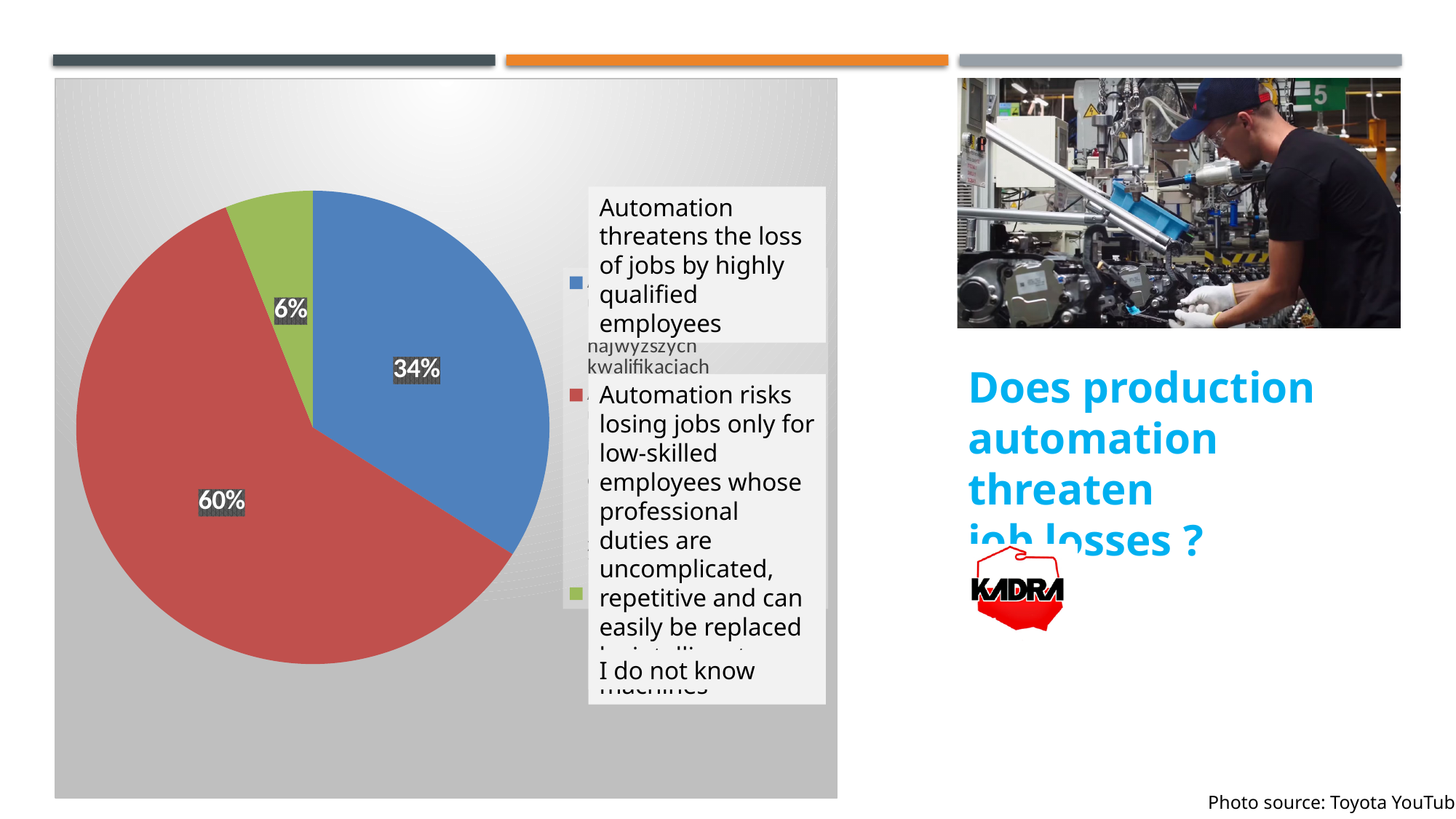
Which is larger: the share for highly qualified employees losing jobs or the share for low-skilled employees losing jobs? low-skilled employees losing jobs (60%) How many slices does the pie chart have? 3 What is the difference in percentage points between the red slice (60%) and the blue slice (34%)? 26 What kind of chart is shown on the slide? pie chart What colour is the slice labelled 60%? red What is the difference in percentage points between the blue slice (34%) and the green slice (6%)? 28 Which slice of the pie chart is the smallest? 6% (I do not know) What colour is the slice labelled 6%? green What share of the pie is the green slice (I do not know)? 6% Which slice of the pie chart is the largest? 60% (automation risks losing jobs only for low-skilled employees) What share of the pie is the blue slice (automation threatens the loss of jobs by highly qualified employees)? 34% What share of the pie is the red slice (automation risks losing jobs only for low-skilled employees)? 60%